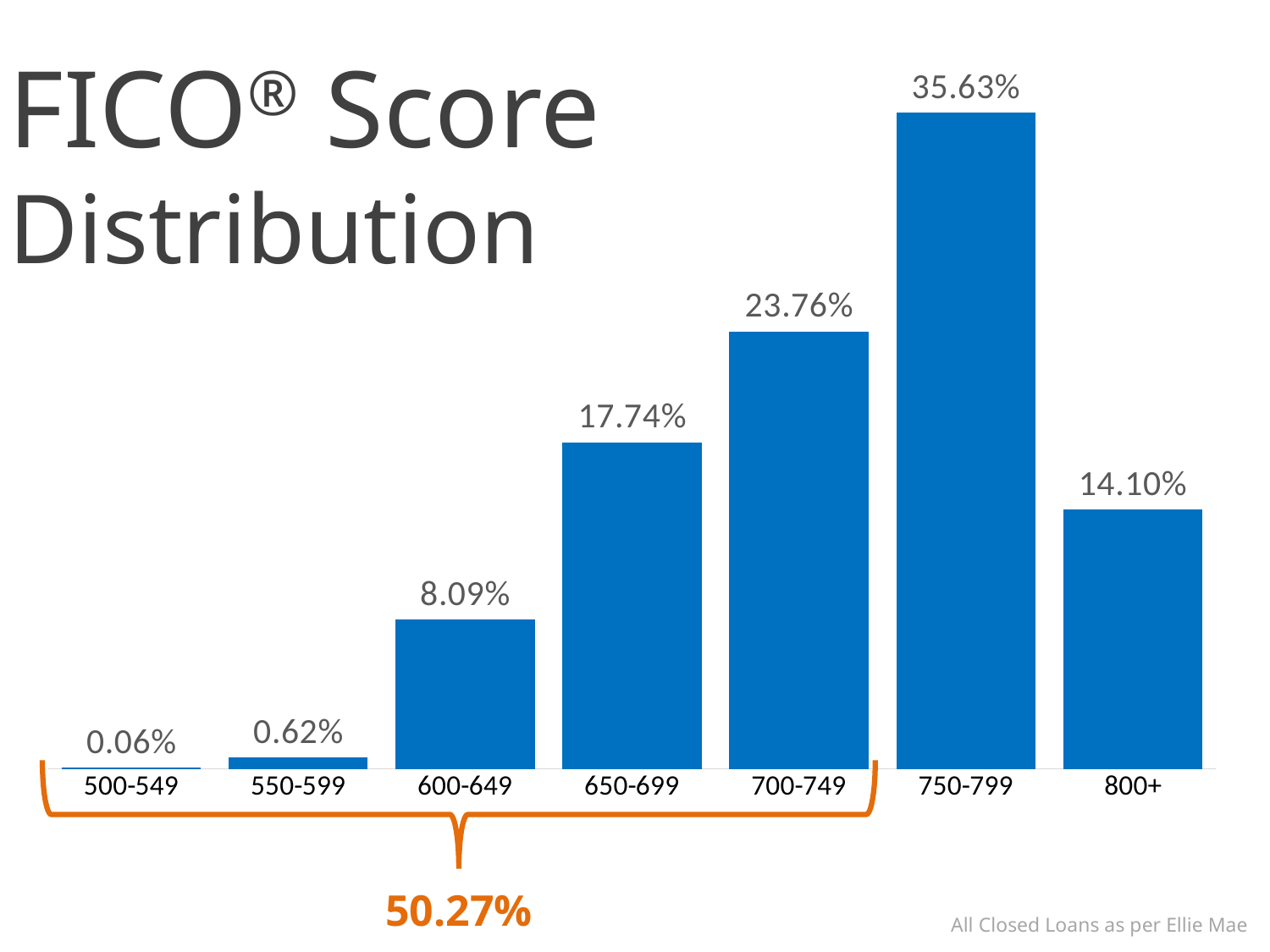
What is the difference between the values for 800+ and 600-649? 6.01% How many FICO score ranges are shown on the chart? 7 Which is larger, the value for 650-699 or the value for 800+? 650-699 Which score range has the highest value? 750-799 What is the value for the 800+ score range? 14.10% Which score range has the lowest value? 500-549 What is the title of the chart? FICO® Score Distribution What is the difference between the values for 750-799 and 700-749? 11.87% What is the value for the 600-649 score range? 8.09% What kind of chart is shown on the slide? bar chart Do the values rise or fall from the 500-549 range to the 750-799 range? rise What is the value for the 750-799 score range? 35.63%